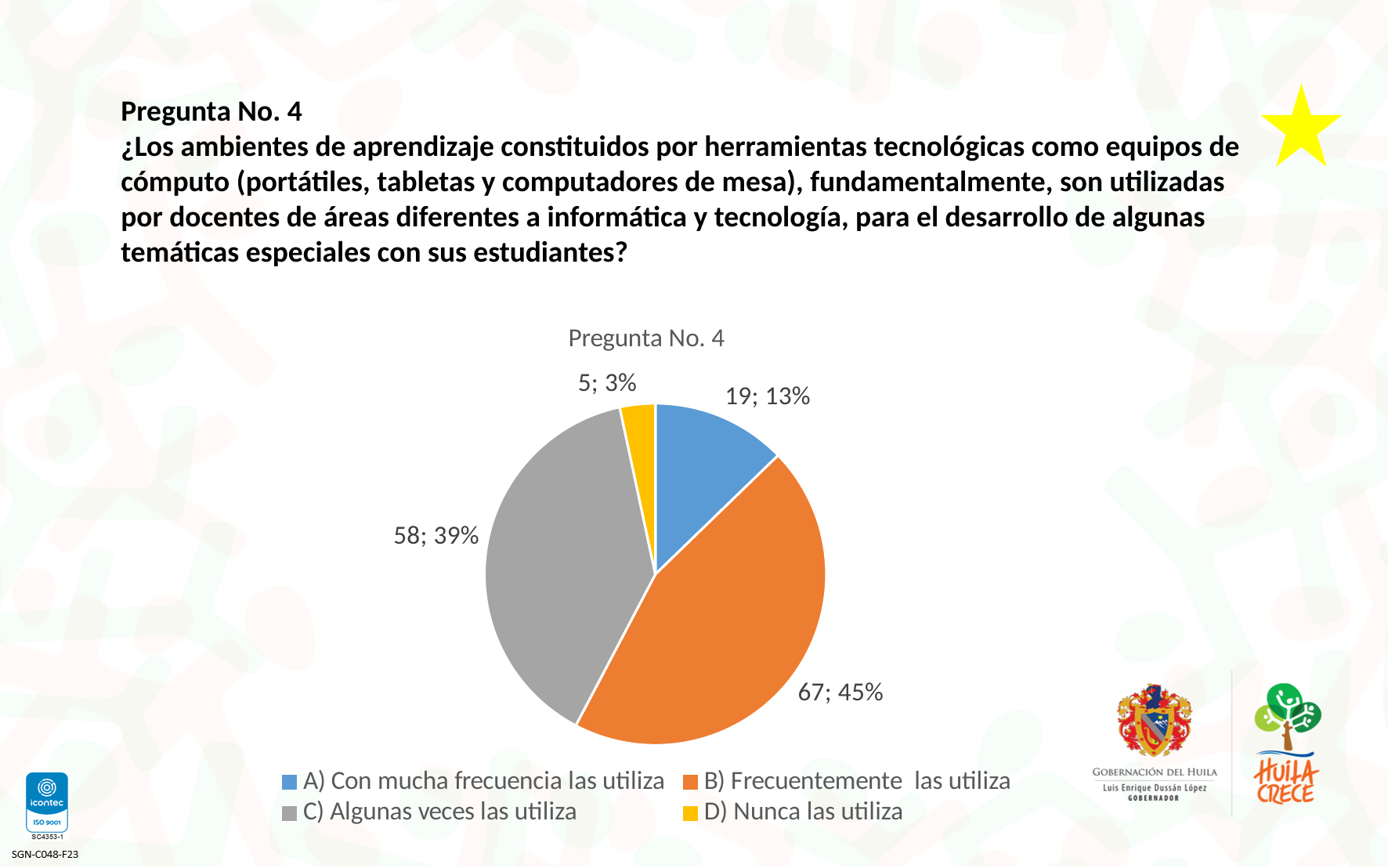
What is the title of the chart? Pregunta No. 4 What percentage share does 'A) Con mucha frecuencia las utiliza' have? 13% What percentage share does 'C) Algunas veces las utiliza' have? 39% What is the difference in count between 'B) Frecuentemente las utiliza' and 'C) Algunas veces las utiliza'? 9 What is the count for 'D) Nunca las utiliza'? 5 What is the count for 'B) Frecuentemente las utiliza'? 67 What kind of chart is shown on the slide? pie chart How many slices does the pie chart have? 4 Which category has the largest slice? B) Frecuentemente las utiliza Which category has the smallest slice? D) Nunca las utiliza Which is larger, the count for 'A) Con mucha frecuencia las utiliza' or for 'D) Nunca las utiliza'? A) Con mucha frecuencia las utiliza How many entries does the legend list? 4